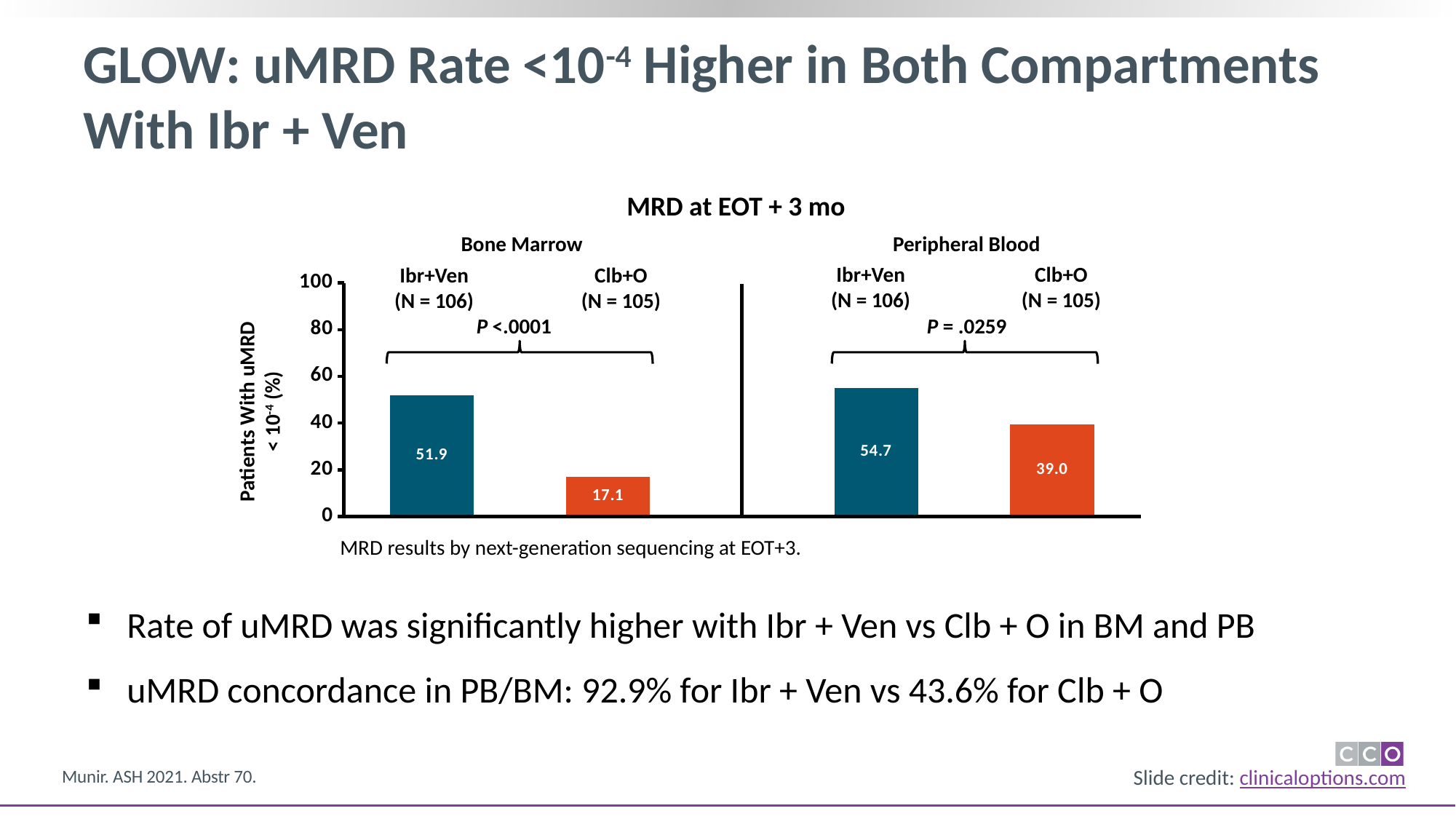
In the MRD at EOT + 3 mo chart, what is the uMRD rate for Clb+O in Bone Marrow? 17.1 In the MRD at EOT + 3 mo chart, what P value is shown for the Peripheral Blood comparison? P = .0259 In the MRD at EOT + 3 mo chart, what is the uMRD rate for Ibr+Ven in Peripheral Blood? 54.7 In the MRD at EOT + 3 mo chart, which is larger: the Clb+O rate in Peripheral Blood or the Clb+O rate in Bone Marrow? Clb+O in Peripheral Blood What kind of chart is shown on the slide? Bar chart In the MRD at EOT + 3 mo chart, how many bars are plotted in total? 4 In the MRD at EOT + 3 mo chart, which bar has the highest value? Ibr+Ven in Peripheral Blood In the MRD at EOT + 3 mo chart, which bar has the lowest value? Clb+O in Bone Marrow In the MRD at EOT + 3 mo chart, what is the difference between the Ibr+Ven and Clb+O uMRD rates in Peripheral Blood? 15.7 In the MRD at EOT + 3 mo chart, what is the uMRD rate for Clb+O in Peripheral Blood? 39.0 In the MRD at EOT + 3 mo chart, what is the difference between the Ibr+Ven and Clb+O uMRD rates in Bone Marrow? 34.8 In the MRD at EOT + 3 mo chart, what is the uMRD rate for Ibr+Ven in Bone Marrow? 51.9